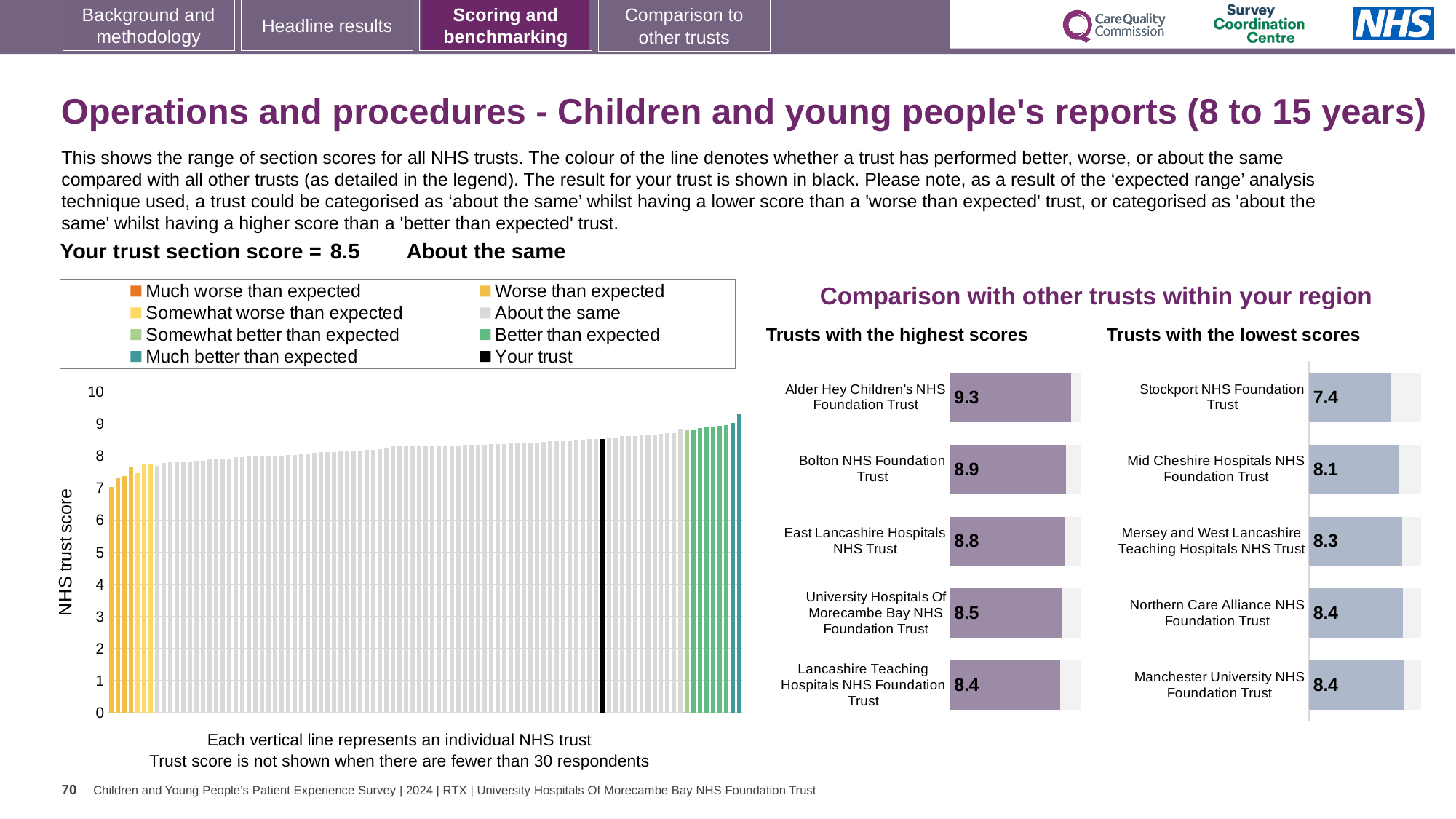
How many entries does the legend of the main 'NHS trust score' chart list? 8 In the 'Trusts with the highest scores' chart, what is the score for Bolton NHS Foundation Trust? 8.9 How many trusts are shown in the 'Trusts with the highest scores' chart? 5 In the 'Trusts with the highest scores' chart, what is the score for Alder Hey Children's NHS Foundation Trust? 9.3 In the 'Trusts with the highest scores' chart, which trust has the highest score? Alder Hey Children's NHS Foundation Trust In the 'Trusts with the lowest scores' chart, what is the score for Stockport NHS Foundation Trust? 7.4 In the main 'NHS trust score' chart on the left, do the bar values rise or fall from left to right? rise In the main 'NHS trust score' chart on the left, is the value for the black 'Your trust' bar greater or less than 8? greater In the 'Trusts with the highest scores' chart, what is the difference between the scores of Alder Hey Children's NHS Foundation Trust and Lancashire Teaching Hospitals NHS Foundation Trust? 0.9 In the 'Trusts with the lowest scores' chart, what is the score for Mid Cheshire Hospitals NHS Foundation Trust? 8.1 In the 'Trusts with the lowest scores' chart, which has the larger score: Mersey and West Lancashire Teaching Hospitals NHS Trust or Mid Cheshire Hospitals NHS Foundation Trust? Mersey and West Lancashire Teaching Hospitals NHS Trust In the 'Trusts with the lowest scores' chart, which trust has the lowest score? Stockport NHS Foundation Trust